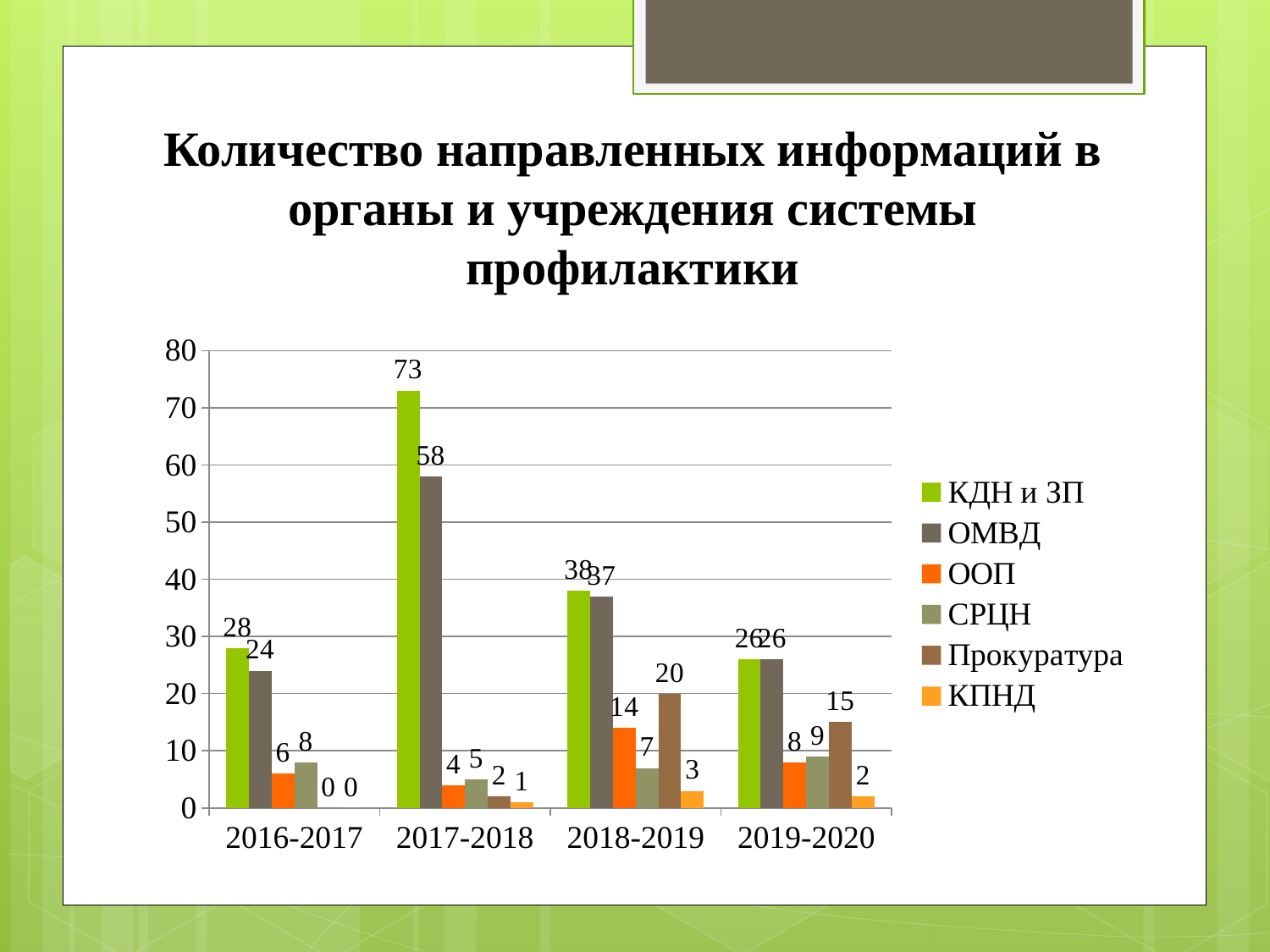
What is the value for СРЦН in 2016-2017? 8 What is the difference between the КДН и ЗП and ОМВД values in 2017-2018? 15 In which period is the value for ОМВД highest? 2017-2018 What is the value for КПНД in 2019-2020? 2 Which is larger in 2018-2019: the value for Прокуратура or the value for ООП? Прокуратура How many periods are shown on the x axis? 4 How many series does the legend list? 6 What kind of chart is shown on the slide? Bar chart What is the value for Прокуратура in 2018-2019? 20 In which period is the value for ООП lowest? 2017-2018 What is the value for КДН и ЗП in 2017-2018? 73